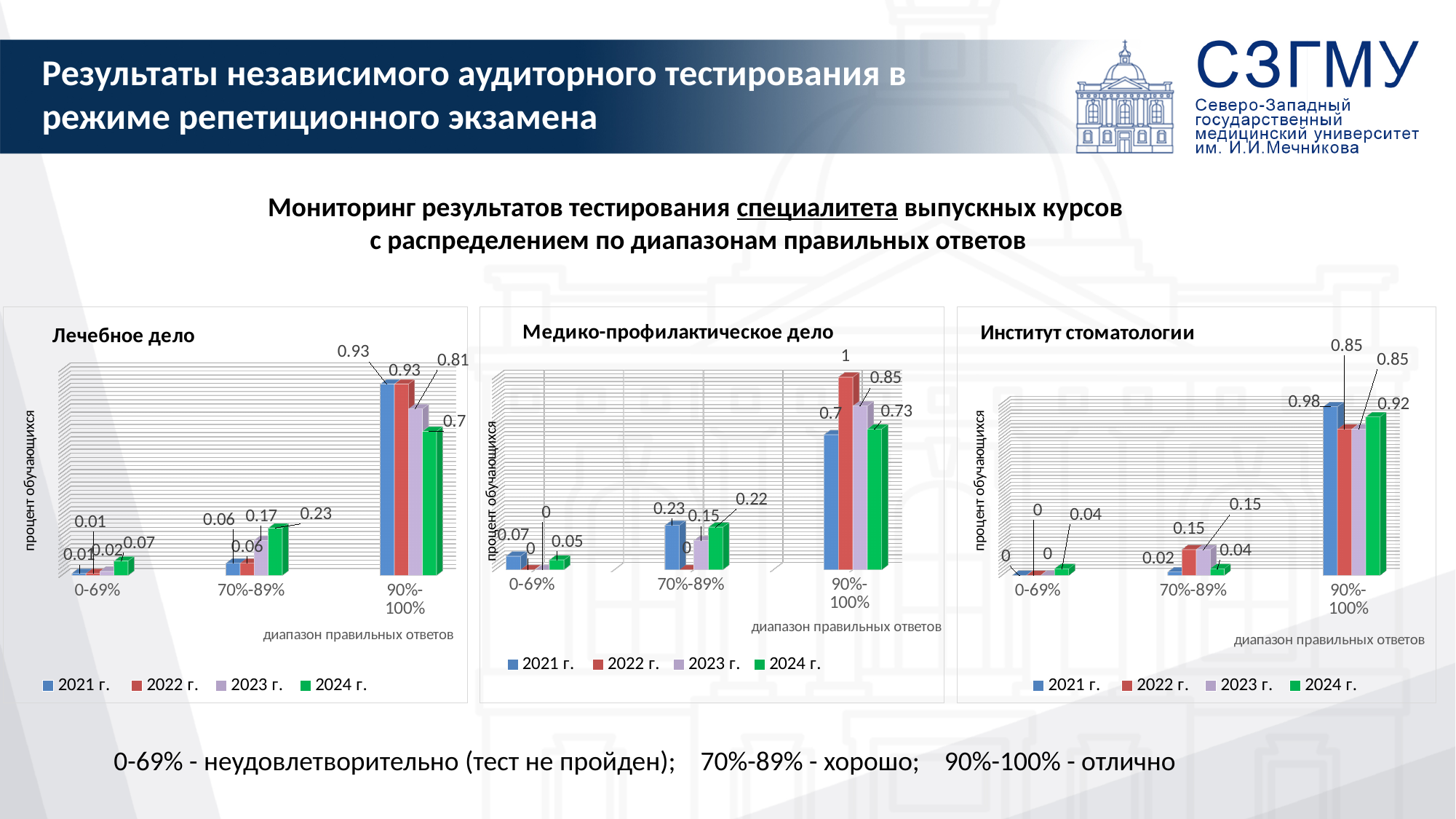
In the 'Институт стоматологии' chart, what is the value for 2021 г. in the 90%-100% range? 0.98 In the 'Лечебное дело' chart, which year has the lowest value in the 90%-100% range? 2024 г. In the 'Медико-профилактическое дело' chart, what is the value for 2021 г. in the 70%-89% range? 0.23 In the 'Лечебное дело' chart, what is the value for 2024 г. in the 90%-100% range? 0.7 In the 'Медико-профилактическое дело' chart, what is the value for 2022 г. in the 90%-100% range? 1 In the 'Лечебное дело' chart, what is the difference between the 2021 г. and 2024 г. values in the 90%-100% range? 0.23 How many series does the legend of the 'Лечебное дело' chart list? 4 In the 'Институт стоматологии' chart, which is larger in the 90%-100% range: 2021 г. or 2024 г.? 2021 г. In the 'Институт стоматологии' chart, what is the value for 2024 г. in the 90%-100% range? 0.92 In the 'Медико-профилактическое дело' chart, which year has the highest value in the 90%-100% range? 2022 г. In the 'Лечебное дело' chart, what is the value for 2024 г. in the 70%-89% range? 0.23 What kind of chart is 'Институт стоматологии'? Bar chart